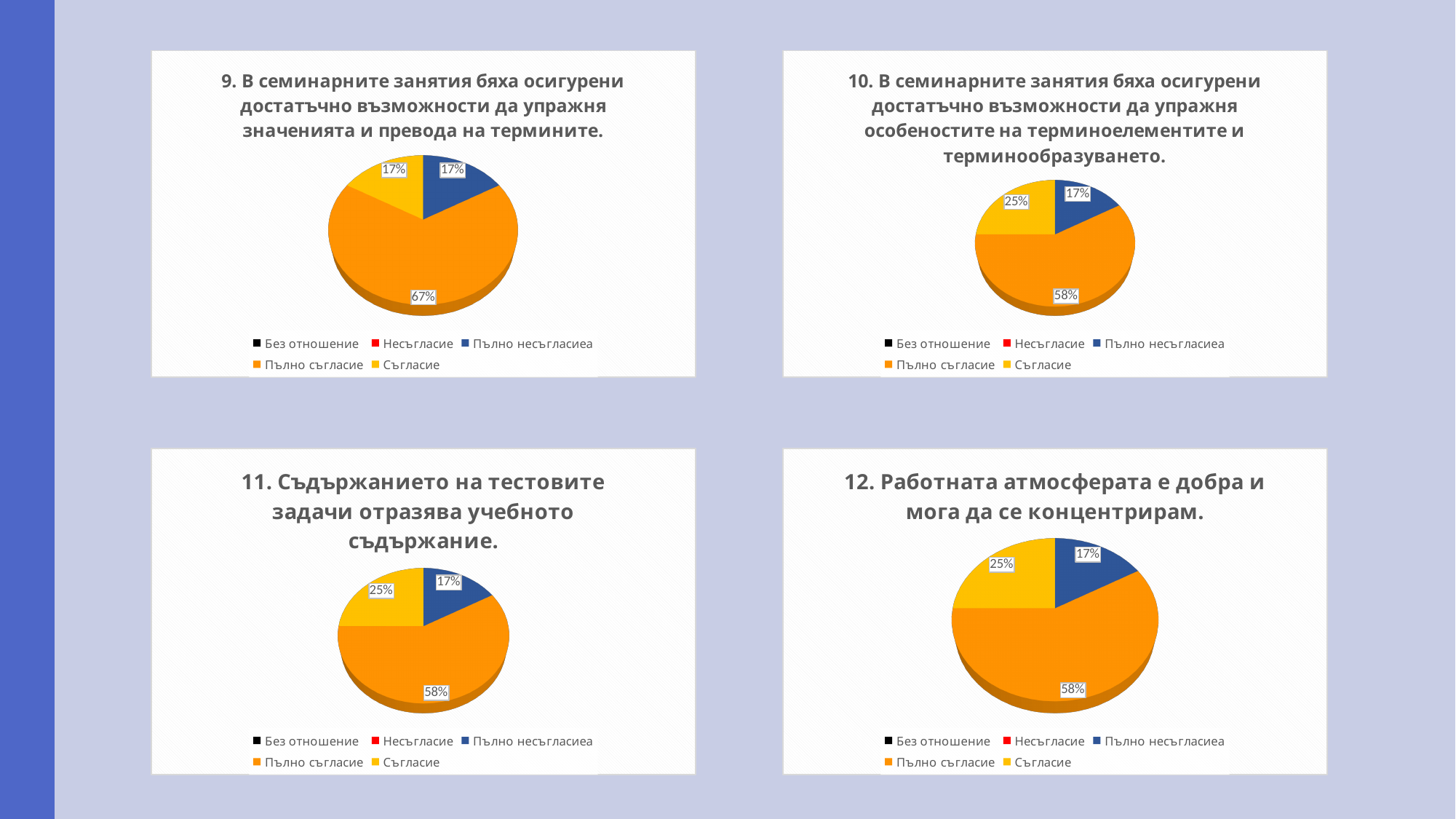
In the top-right chart (question 10), what share does the 'Пълно съгласие' slice have? 58% In the top-right chart (question 10), what share does the 'Съгласие' slice have? 25% In the top-left chart (question 9), what share does the 'Съгласие' slice have? 17% How many entries does the legend of the top-left chart (question 9) list? 5 In the top-left chart (question 9), which category has the largest slice? Пълно съгласие What type of chart is used in the bottom-right chart (question 12)? Pie chart In the bottom-left chart (question 11), which slice is larger: 'Съгласие' or 'Пълно несъгласиеа'? Съгласие In the bottom-right chart (question 12), which category has the largest slice? Пълно съгласие In the top-right chart (question 10), what is the difference between the 'Пълно съгласие' and 'Съгласие' shares? 33%